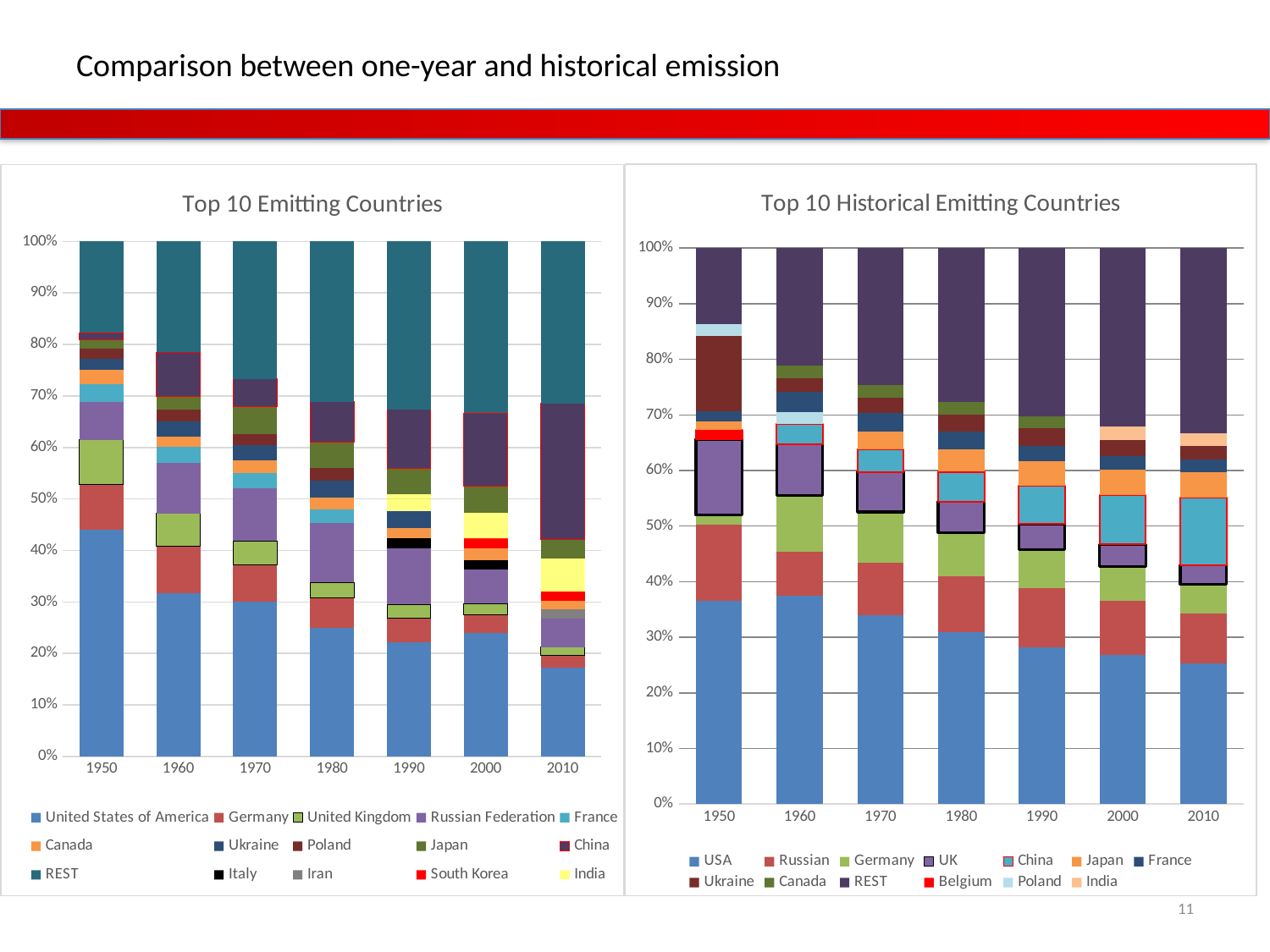
In the "Top 10 Emitting Countries" chart, is the United States of America share in 2010 greater or less than 20%? less What is the title of the chart on the right side of the slide? Top 10 Historical Emitting Countries In the "Top 10 Historical Emitting Countries" chart, is the USA share in 1950 greater or less than 30%? greater In the "Top 10 Emitting Countries" chart, does the United States of America share rise or fall from 1950 to 2010? fall In the "Top 10 Emitting Countries" chart, is the United States of America share in 1950 greater or less than 40%? greater In the "Top 10 Emitting Countries" chart, which year has the larger United States of America share, 1950 or 2010? 1950 How many series does the legend of the "Top 10 Historical Emitting Countries" chart list? 13 How many series does the legend of the "Top 10 Emitting Countries" chart list? 15 What kind of chart is the "Top 10 Emitting Countries" chart? Stacked bar chart How many years are shown on the x axis of the "Top 10 Historical Emitting Countries" chart? 7 What is the total of each stacked bar in the "Top 10 Historical Emitting Countries" chart? 100%